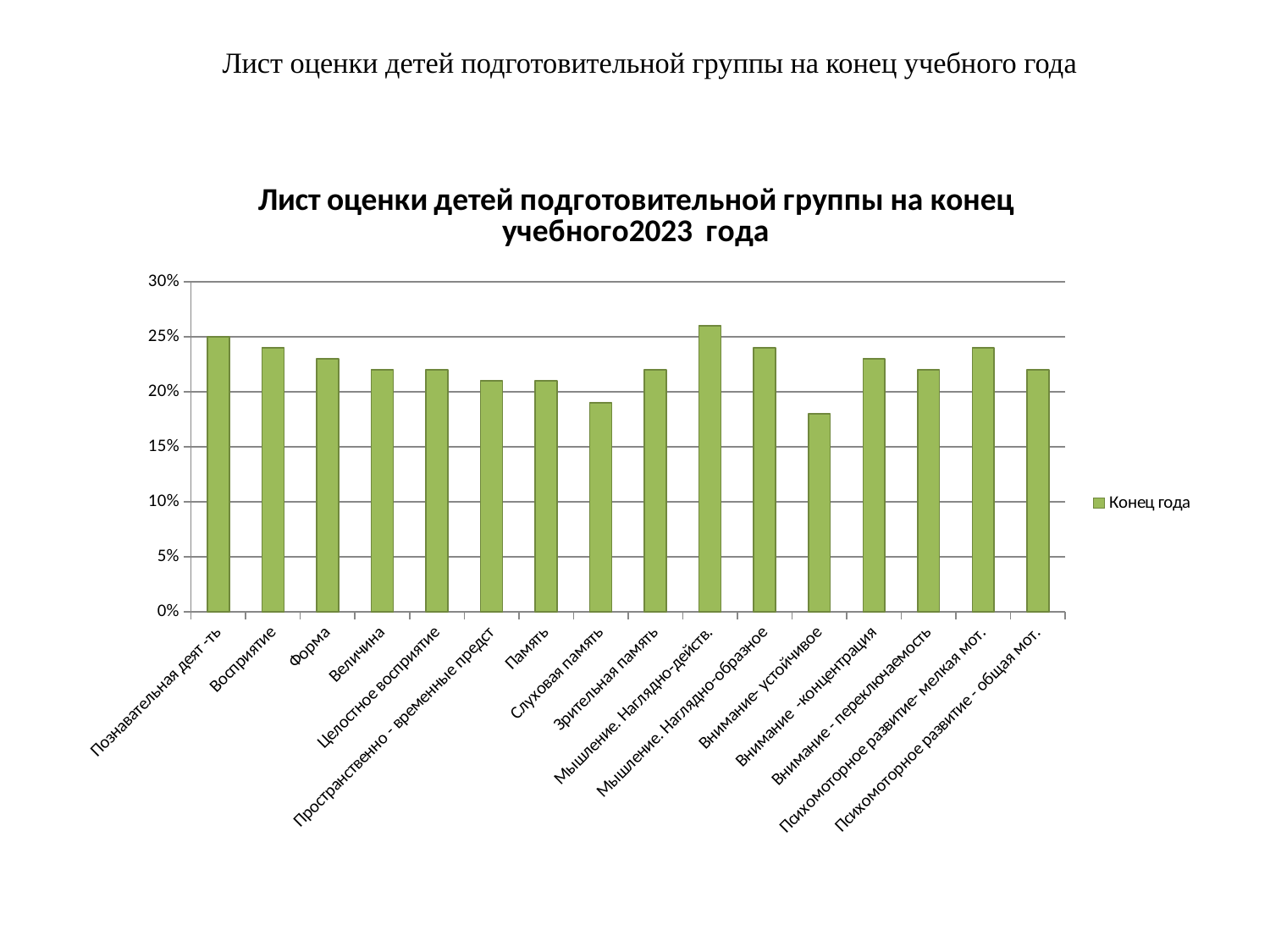
Which is larger, the value for Восприятие or the value for Внимание- устойчивое? Восприятие Is the value for Мышление. Наглядно-действ. greater or less than 25%? greater How many categories are plotted along the x axis of the chart? 16 Which is larger, the value for Слуховая память or the value for Зрительная память? Зрительная память Which category has the lowest value in the chart? Внимание- устойчивое Is the value for Форма greater or less than 25%? less What kind of chart is shown on the slide? bar chart What is the value for Познавательная деят -ть? 25% How many series does the chart's legend list? 1 What is the name of the series shown in the chart's legend? Конец года Which category has the highest value in the chart? Мышление. Наглядно-действ. Is the value for Слуховая память greater or less than 20%? less